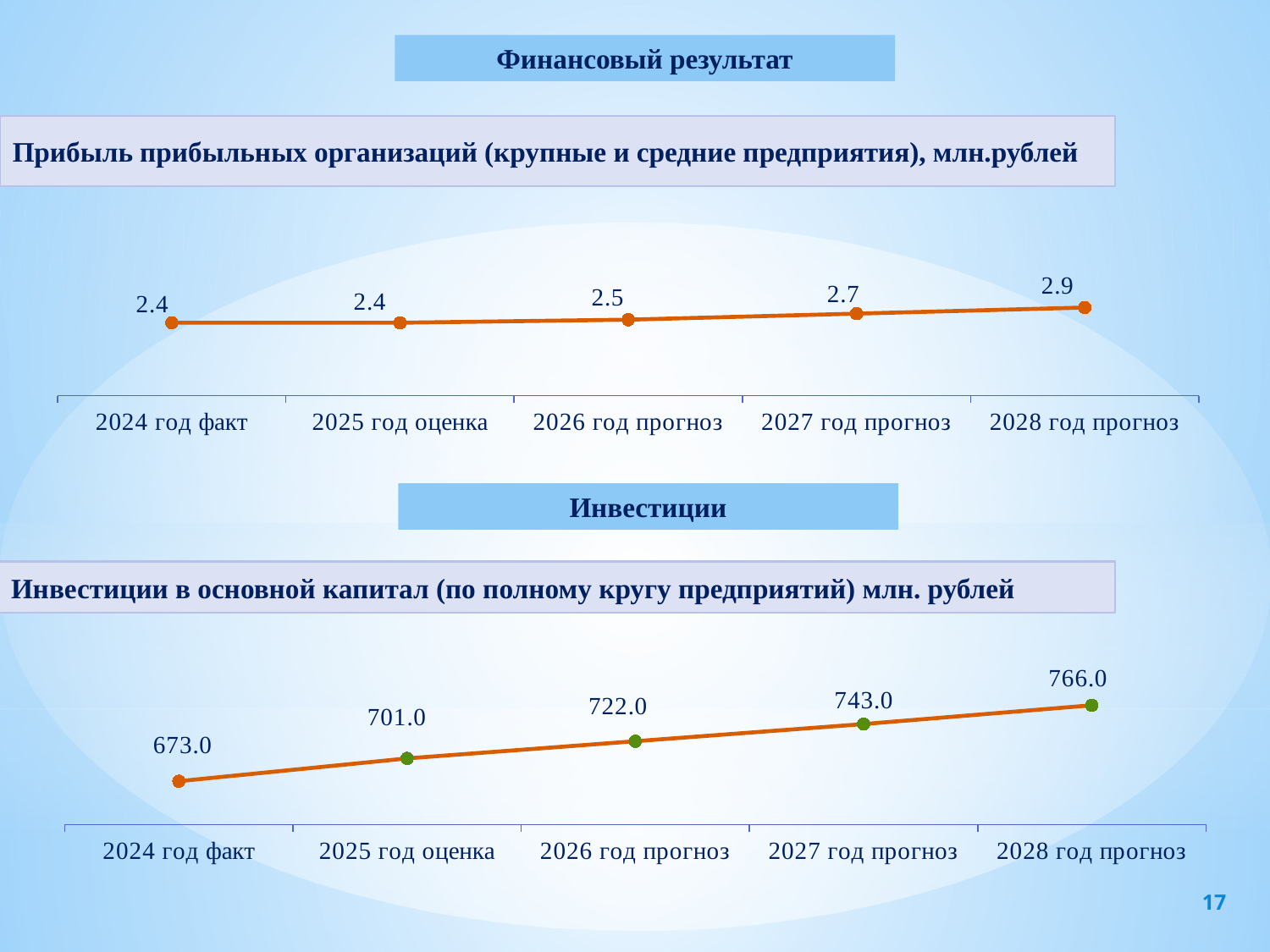
In the bottom chart (Инвестиции в основной капитал), which is larger: the value for 2026 год прогноз or 2025 год оценка? 2026 год прогноз In the top chart (Прибыль прибыльных организаций), what is the value for 2026 год прогноз? 2.5 In the top chart (Прибыль прибыльных организаций), what is the difference between the values for 2028 год прогноз and 2024 год факт? 0.5 In the bottom chart (Инвестиции в основной капитал), what is the value for 2025 год оценка? 701.0 In the top chart (Прибыль прибыльных организаций), do the values rise or fall from 2024 to 2028? rise In the bottom chart (Инвестиции в основной капитал), which category has the lowest value? 2024 год факт In the top chart (Прибыль прибыльных организаций), which category has the highest value? 2028 год прогноз In the bottom chart (Инвестиции в основной капитал), what is the value for 2027 год прогноз? 743.0 What type of chart is the bottom chart (Инвестиции в основной капитал)? line chart In the top chart (Прибыль прибыльных организаций), what is the value for 2028 год прогноз? 2.9 In the bottom chart (Инвестиции в основной капитал), what is the difference between the values for 2028 год прогноз and 2024 год факт? 93.0 In the top chart (Прибыль прибыльных организаций), how many data points are plotted? 5